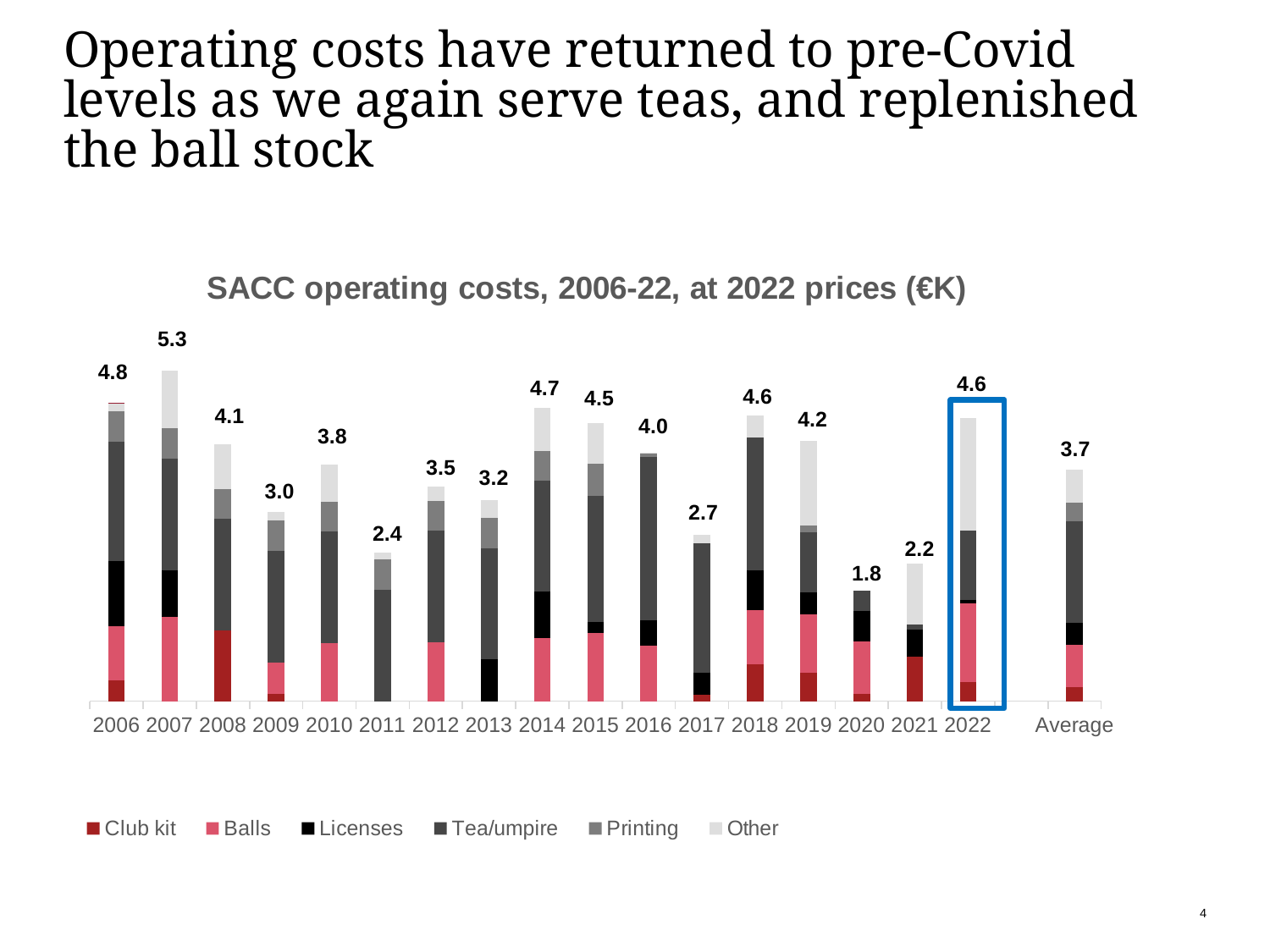
What is the total operating cost shown for 2020? 1.8 How many series does the legend list? 6 Which year has the lowest total operating cost? 2020 What is the difference between the total for 2022 and the total for 2021? 2.4 What is the difference between the total for 2007 and the total for 2020? 3.5 Which is larger, the total for 2014 or the total for 2015? 2014 How many bars are plotted on the chart, including the Average bar? 18 What is the title of the chart? SACC operating costs, 2006-22, at 2022 prices (€K) What is the value shown for the Average bar? 3.7 What is the total operating cost shown for 2007? 5.3 Which year has the highest total operating cost? 2007 What kind of chart is shown on the slide? Stacked bar chart